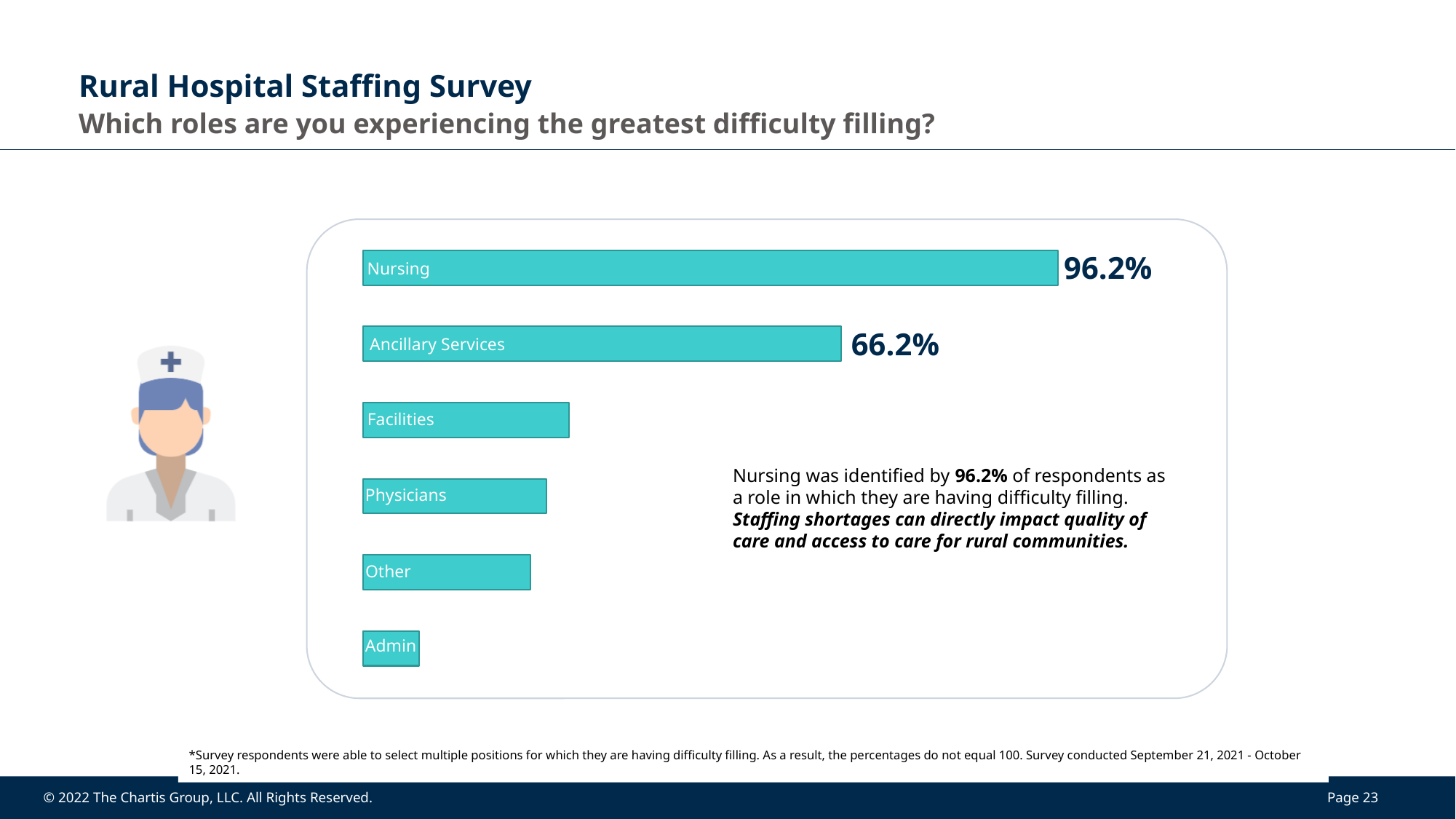
Which role has the highest value in the chart? Nursing Which role is listed second from the top in the chart? Ancillary Services What percentage of respondents identified Nursing as a role they are having difficulty filling? 96.2% Which has a larger value, Facilities or Admin? Facilities How many roles are shown in the chart? 6 Which has a larger value, Other or Admin? Other What survey question does the chart answer, as shown in the slide subtitle? Which roles are you experiencing the greatest difficulty filling? Which has a larger value, Physicians or Admin? Physicians Which role has the shortest bar in the chart? Admin What type of chart is shown on the slide? Bar chart What is the difference between the values for Nursing and Ancillary Services? 30.0% What is the value shown for Ancillary Services? 66.2%